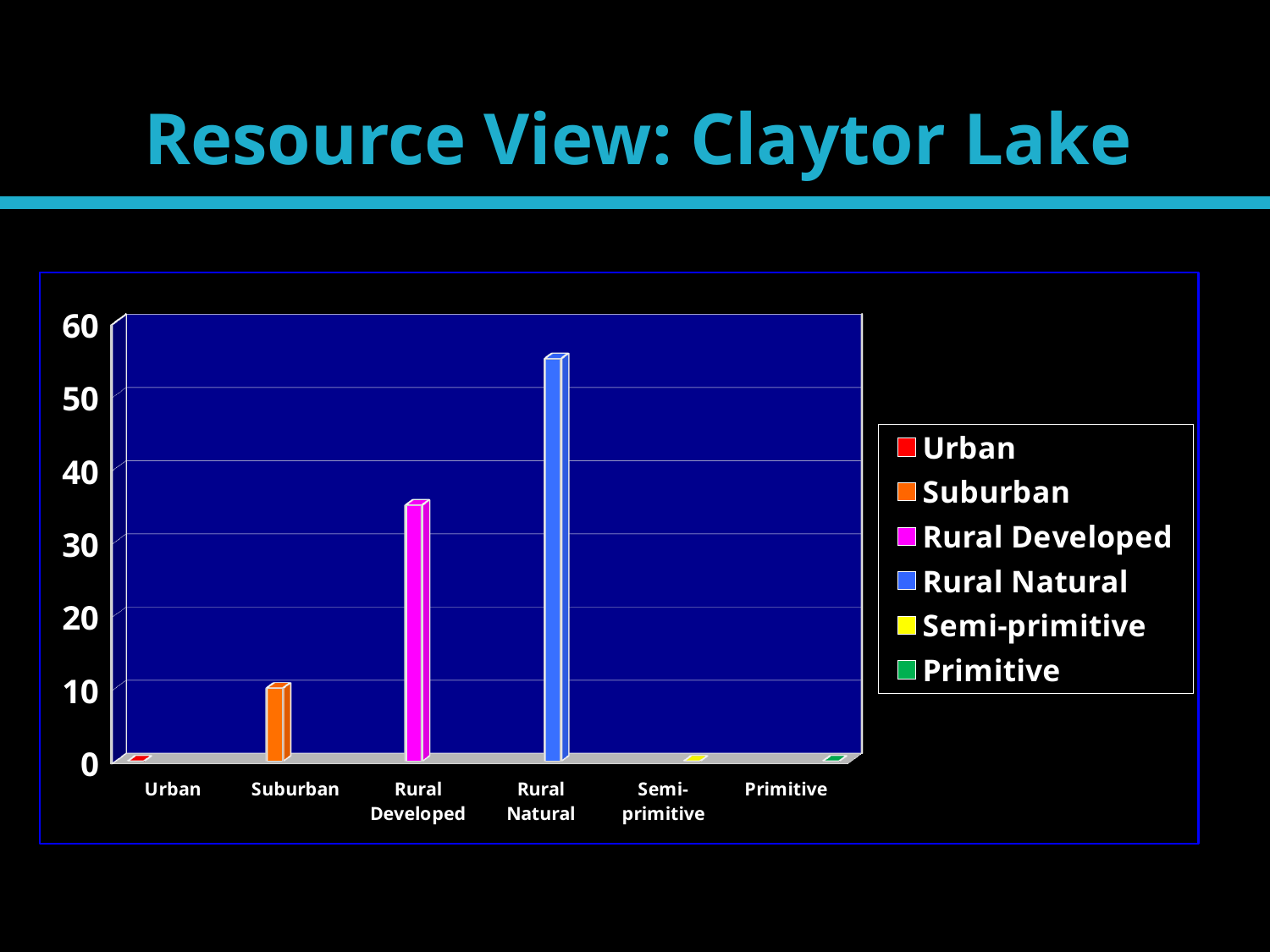
Is the value for Suburban greater or less than 20? less How many categories are shown on the x axis? 6 Is the value for Rural Developed greater or less than 40? less Is the value for Rural Developed greater or less than 30? greater What kind of chart is shown on the slide? bar chart Which category has the highest value? Rural Natural How many entries does the legend list? 6 What is the title of the slide containing the chart? Resource View: Claytor Lake What colour is the Rural Developed bar? magenta Which is larger, the value for Rural Developed or the value for Suburban? Rural Developed